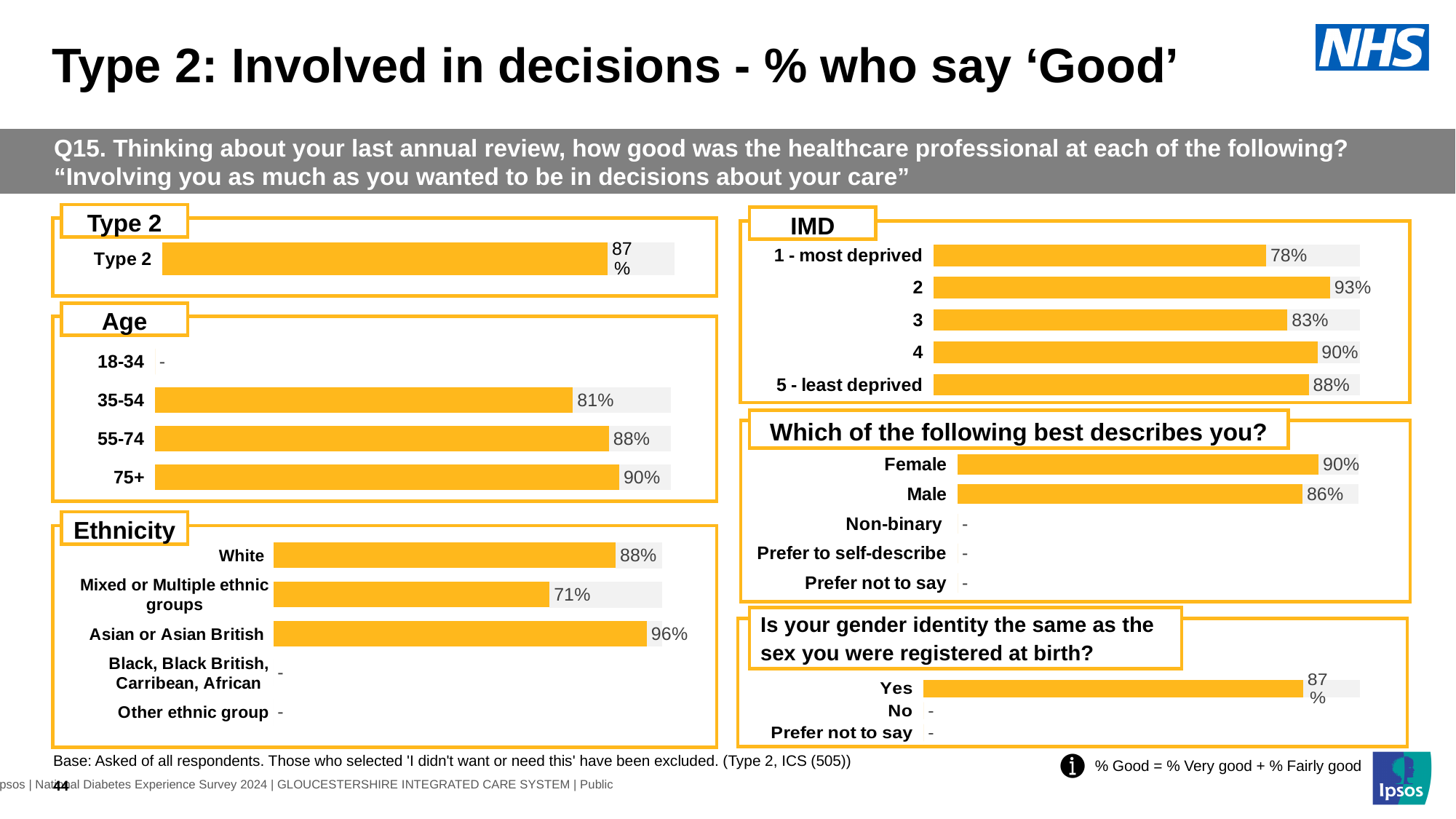
What type of chart is used in the IMD section? Bar chart In the Ethnicity chart, what is the value for Mixed or Multiple ethnic groups? 71% In the Age chart, which age group with a printed value has the lowest percentage? 35-54 In the 'Is your gender identity the same as the sex you were registered at birth?' chart, what is the value for Yes? 87% In the IMD chart, what is the difference between IMD group 2 and IMD group 3? 10 percentage points In the IMD chart, what is the value for 1 - most deprived? 78% In the Age chart, what is the difference between the 75+ and 35-54 values? 9 percentage points In the Type 2 chart, what percentage of Type 2 respondents say 'Good'? 87% In the IMD chart, which IMD group has the highest percentage? 2 In the Age chart, what is the value for the 75+ age group? 90% In the Ethnicity chart, which ethnic group has the highest percentage? Asian or Asian British In the 'Which of the following best describes you?' chart, which is larger, Female or Male? Female